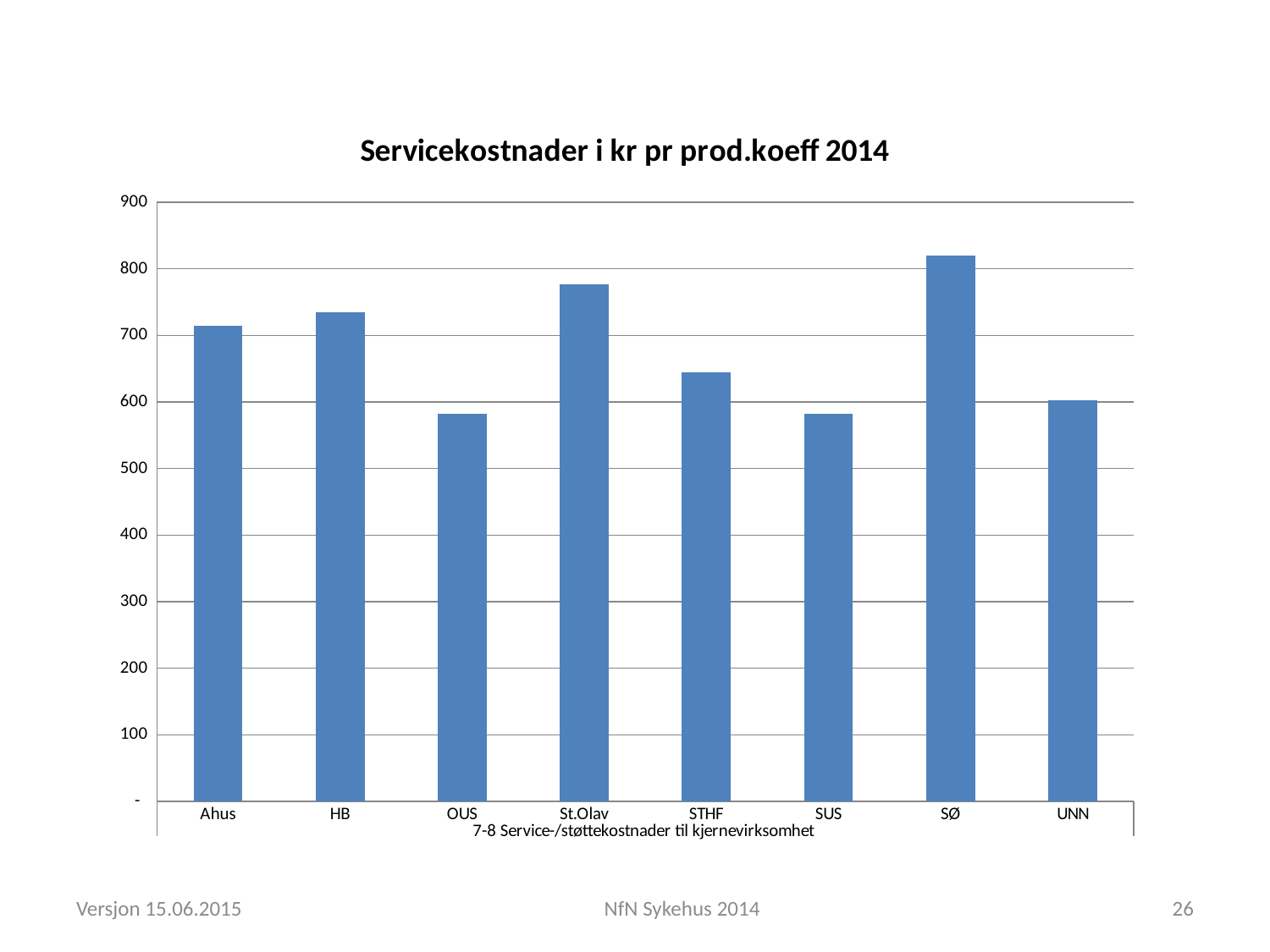
Which is larger, the value for STHF or the value for UNN? STHF What is the title of the chart? Servicekostnader i kr pr prod.koeff 2014 What is the label shown below the category names on the x axis? 7-8 Service-/støttekostnader til kjernevirksomhet What type of chart is shown on the slide? Bar chart Is the value for STHF greater or less than 700? less Is the value for OUS greater or less than 600? less Which is larger, the value for St.Olav or the value for HB? St.Olav Is the value for SØ greater or less than 800? greater How many hospitals (categories) are shown on the x axis? 8 Which hospital has the highest service cost per prod.koeff? SØ